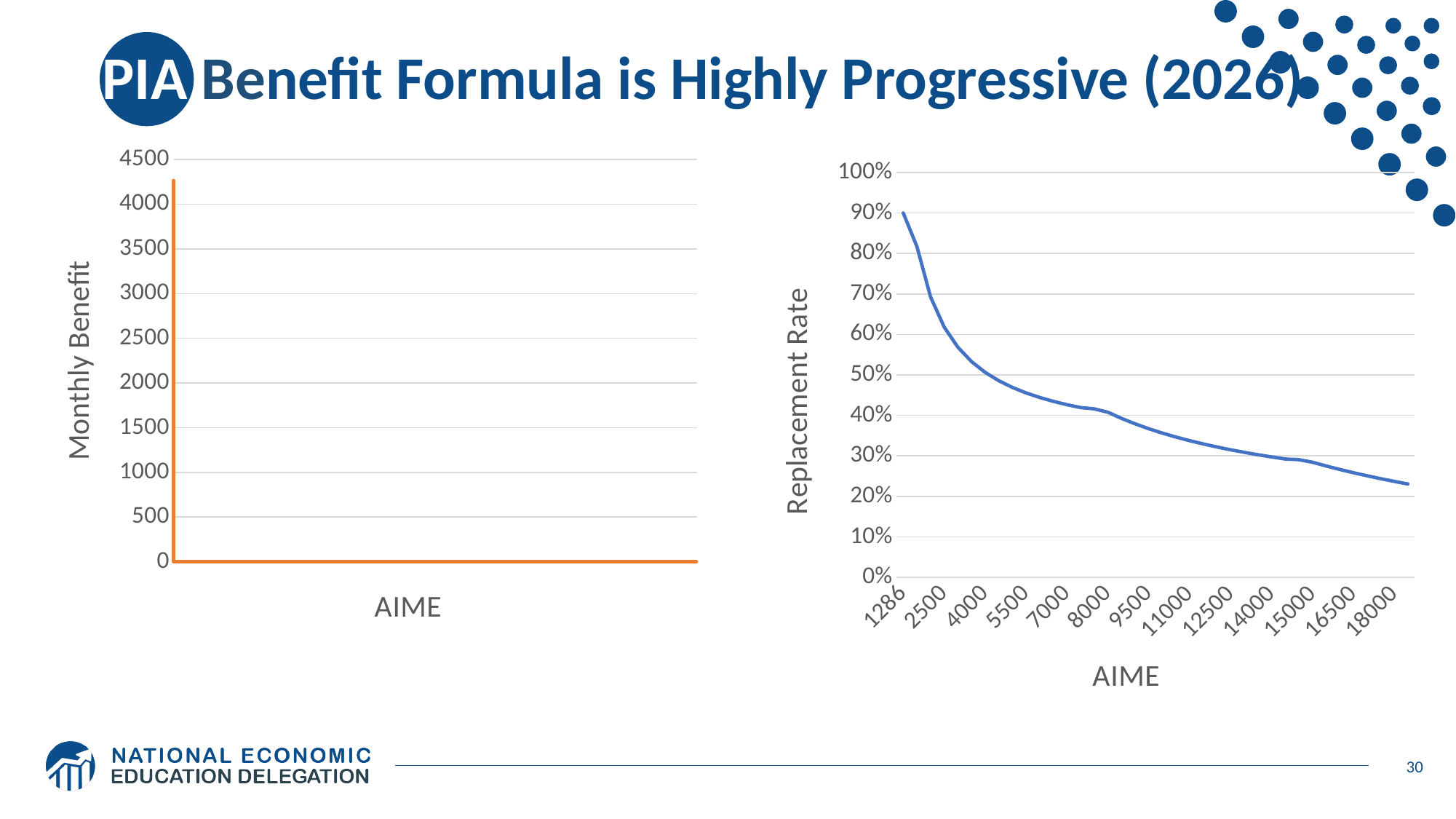
What is the y-axis title of the left-hand chart? Monthly Benefit How many AIME labels are shown on the x axis of the right-hand chart? 13 In the right-hand chart, at which AIME value is the replacement rate highest? 1286 In the right-hand chart, is the replacement rate at AIME 8000 greater or less than 50%? less In the right-hand chart, is the replacement rate at AIME 18000 greater or less than 30%? less What kind of chart is the right-hand chart (Replacement Rate vs AIME)? line chart In the right-hand chart, is the replacement rate at AIME 15000 greater or less than 20%? greater In the right-hand chart, does the replacement rate rise or fall as AIME increases? fall In the right-hand chart, which has the higher replacement rate: AIME 2500 or AIME 14000? 2500